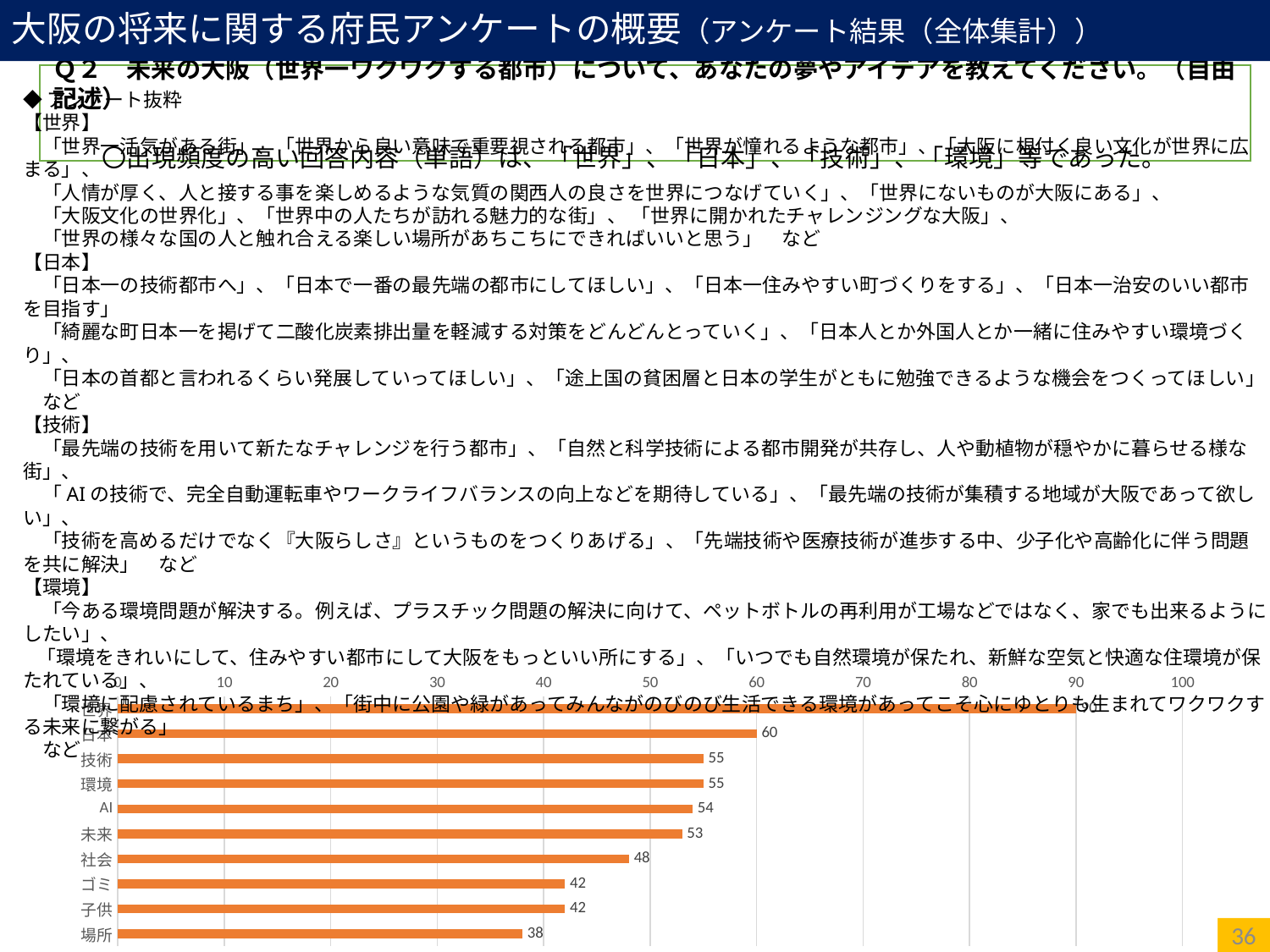
What is the value for AI in the bar chart? 54 What is the value for 場所 in the bar chart? 38 Which category has the lowest value in the bar chart? 場所 Which has a larger value in the bar chart, 未来 or 子供? 未来 What is the value for 技術 in the bar chart? 55 What is the value for 日本 in the bar chart? 60 What is the difference between the values for 社会 and ゴミ in the bar chart? 6 What is the value for 未来 in the bar chart? 53 What type of chart is shown at the bottom of the slide? bar chart How many bars are shown in the bar chart? 10 What is the difference between the values for 日本 and 技術 in the bar chart? 5 What is the value for 社会 in the bar chart? 48